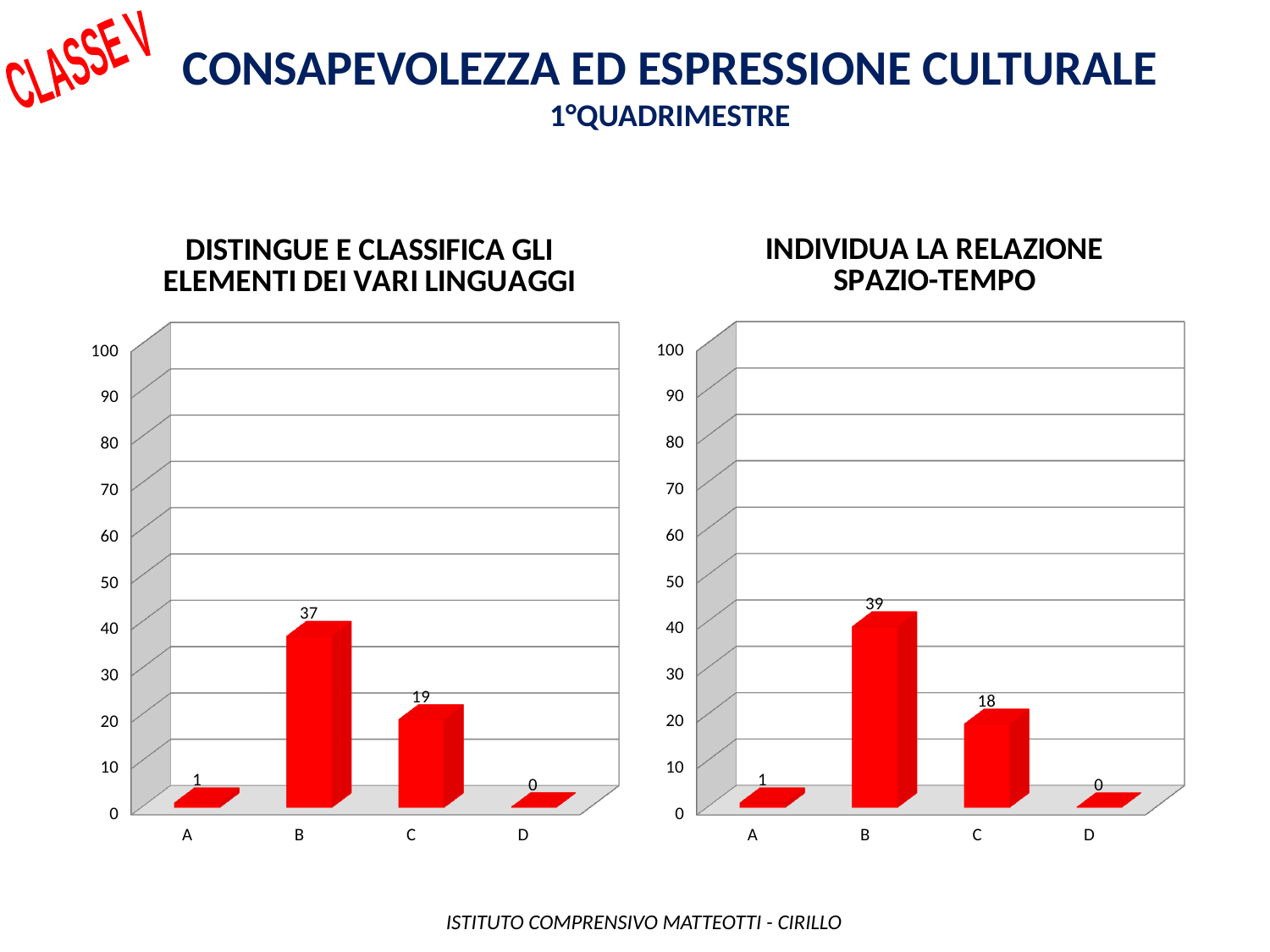
How many categories are shown on the x axis of the left chart? 4 In the right chart, which category has the lowest value? D In the chart titled "DISTINGUE E CLASSIFICA GLI ELEMENTI DEI VARI LINGUAGGI", what is the value for category B? 37 In the chart titled "INDIVIDUA LA RELAZIONE SPAZIO-TEMPO", what is the value for category C? 18 In the left chart, what is the value for category D? 0 In the right chart, is the value for B greater or less than 30? greater In the chart titled "INDIVIDUA LA RELAZIONE SPAZIO-TEMPO", what is the difference between the values for B and A? 38 In the left chart, which category has the highest value? B What colour are the bars in both charts? Red Which is larger: the value for B in the left chart or the value for B in the right chart? B in the right chart In the chart titled "DISTINGUE E CLASSIFICA GLI ELEMENTI DEI VARI LINGUAGGI", what is the difference between the values for B and C? 18 What kind of chart is the chart titled "INDIVIDUA LA RELAZIONE SPAZIO-TEMPO"? Bar chart